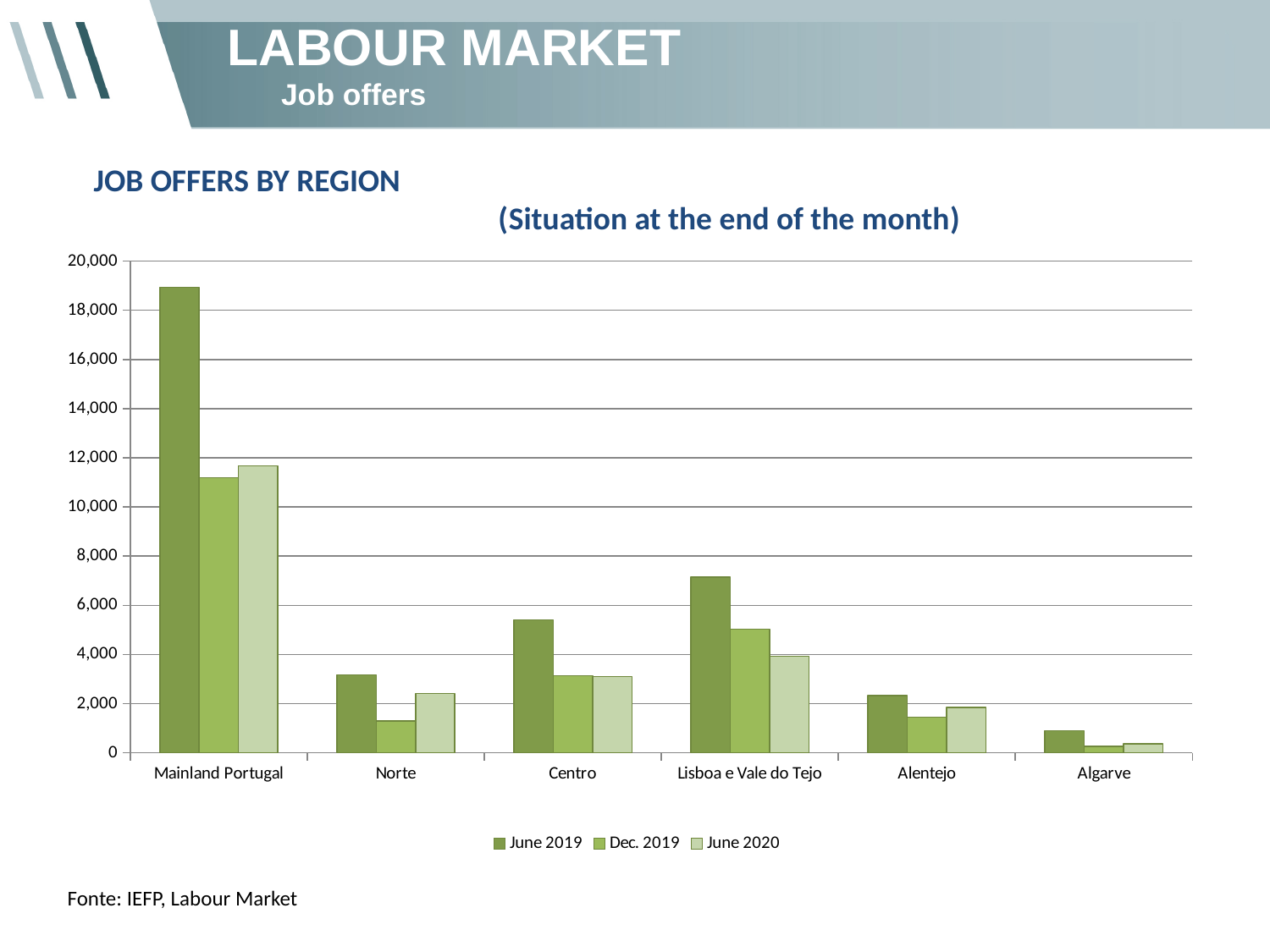
For Norte, which is larger, the Dec. 2019 value or the June 2020 value? June 2020 How many series does the legend list? 3 What are the three series listed in the legend? June 2019, Dec. 2019, June 2020 Which is larger, the June 2019 value for Centro or the June 2019 value for Lisboa e Vale do Tejo? Lisboa e Vale do Tejo Which region has the highest June 2019 value? Mainland Portugal How many regions are shown on the x axis? 6 Is the June 2020 value for Centro greater or less than 4,000? less Is the June 2019 value for Lisboa e Vale do Tejo greater or less than 6,000? greater Is the Dec. 2019 value for Norte greater or less than 2,000? less What kind of chart is shown on the slide? bar chart Which region has the lowest June 2019 value? Algarve